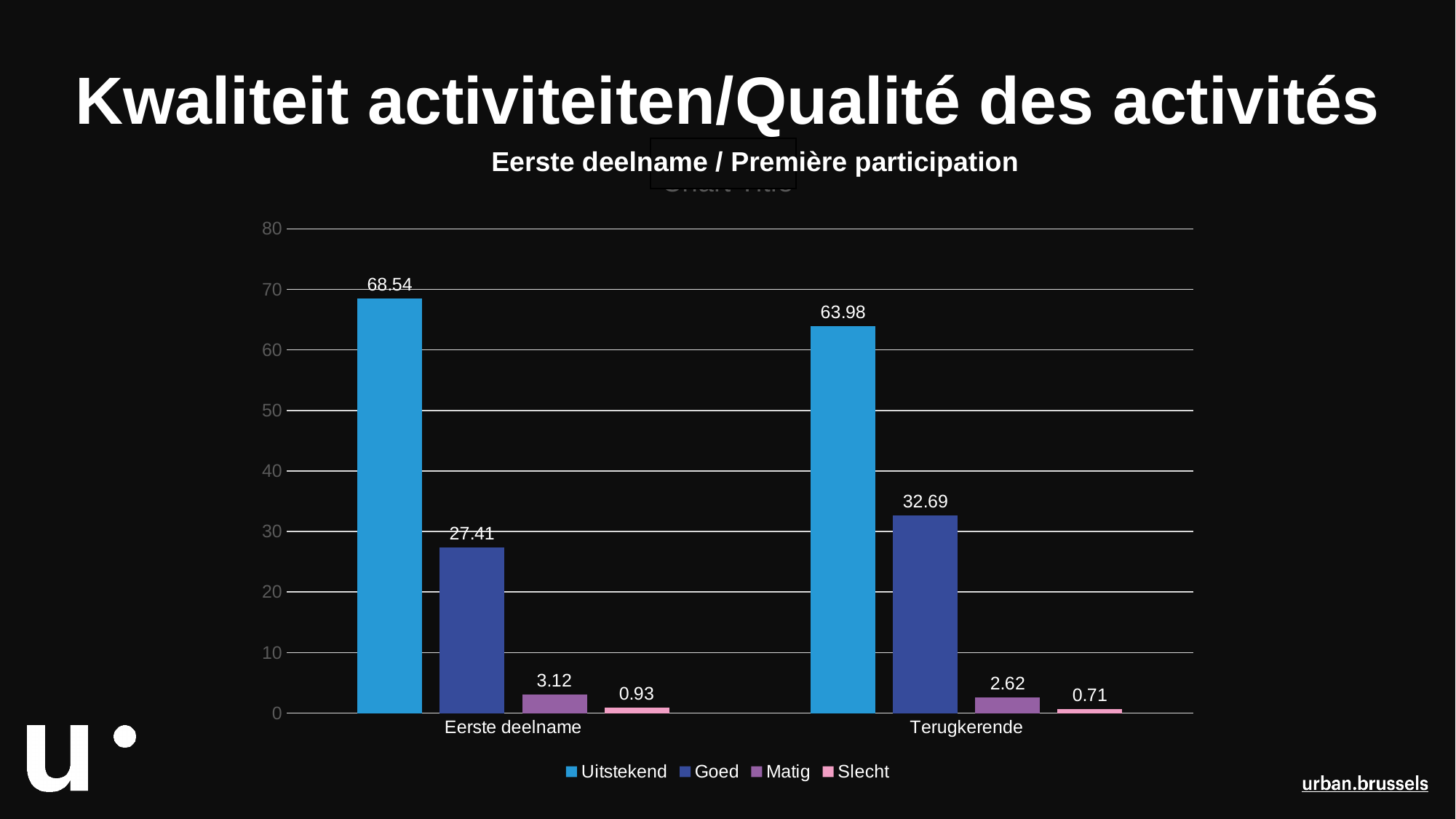
Which category has the larger Goed value, Eerste deelname or Terugkerende? Terugkerende How many series does the legend list? 4 What is the difference between the Uitstekend values for Eerste deelname and Terugkerende? 4.56 What is the value for Matig in the Terugkerende category? 2.62 Which series has the lowest value in the Eerste deelname category? Slecht Which series has the highest value in the Terugkerende category? Uitstekend What is the value for Goed in the Terugkerende category? 32.69 What is the value for Uitstekend in the Eerste deelname category? 68.54 Is the Uitstekend value for Terugkerende greater or less than 60? greater How many categories are shown on the x axis? 2 What kind of chart is shown on the slide? Bar chart What is the value for Slecht in the Eerste deelname category? 0.93